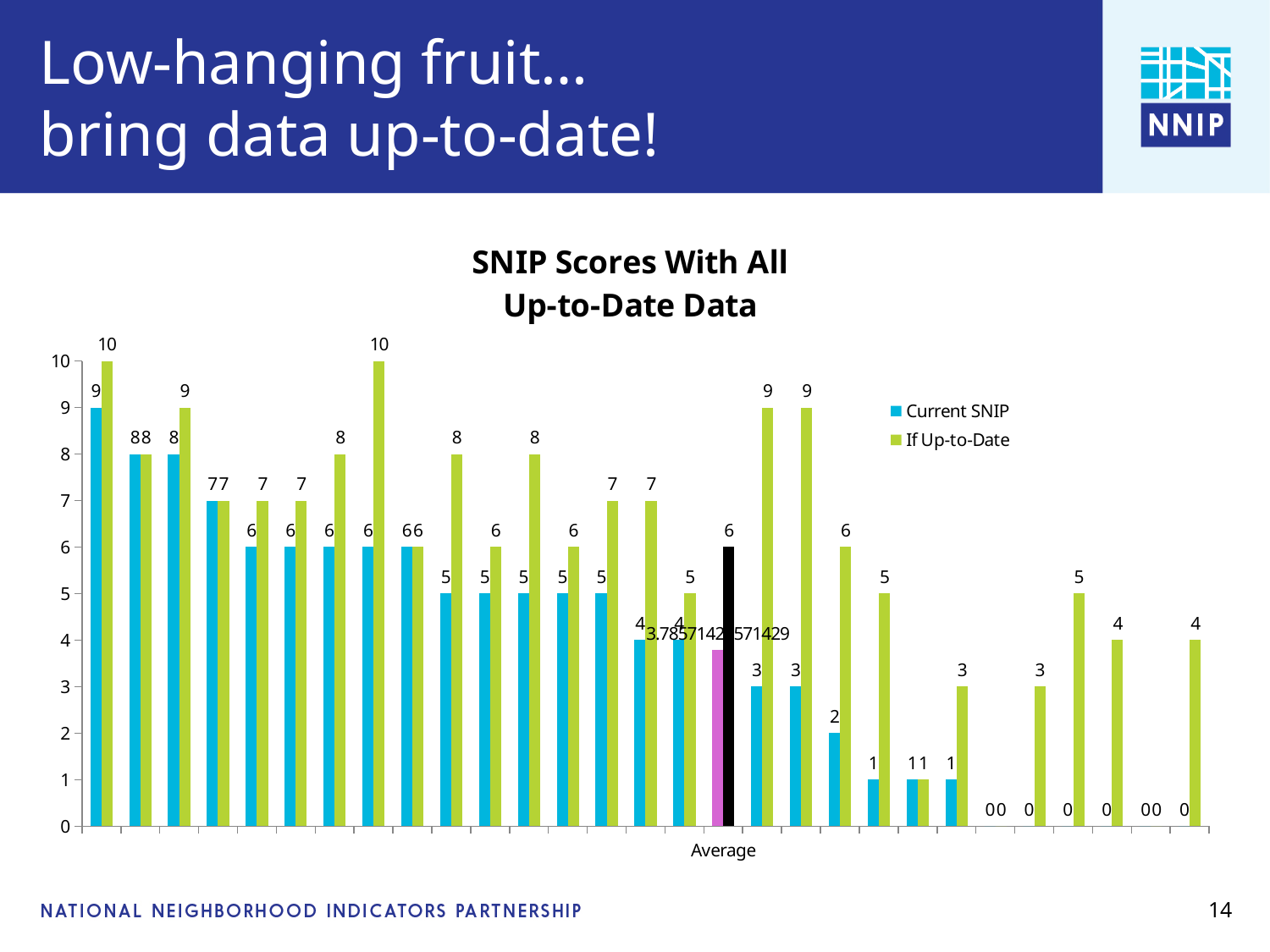
What is the title of the chart? SNIP Scores With All Up-to-Date Data What are the two series named in the legend? Current SNIP and If Up-to-Date Is the Current SNIP value for Average greater or less than 4? less What is the lowest value labeled on any bar in the chart? 0 What is the If Up-to-Date value for the Average category? 6 What kind of chart is shown on the slide? bar chart How many series does the legend list? 2 What is the highest value labeled on any bar in the chart? 10 For the Average category, which series has the larger value, Current SNIP or If Up-to-Date? If Up-to-Date Is the Current SNIP value for Average greater or less than 3? greater